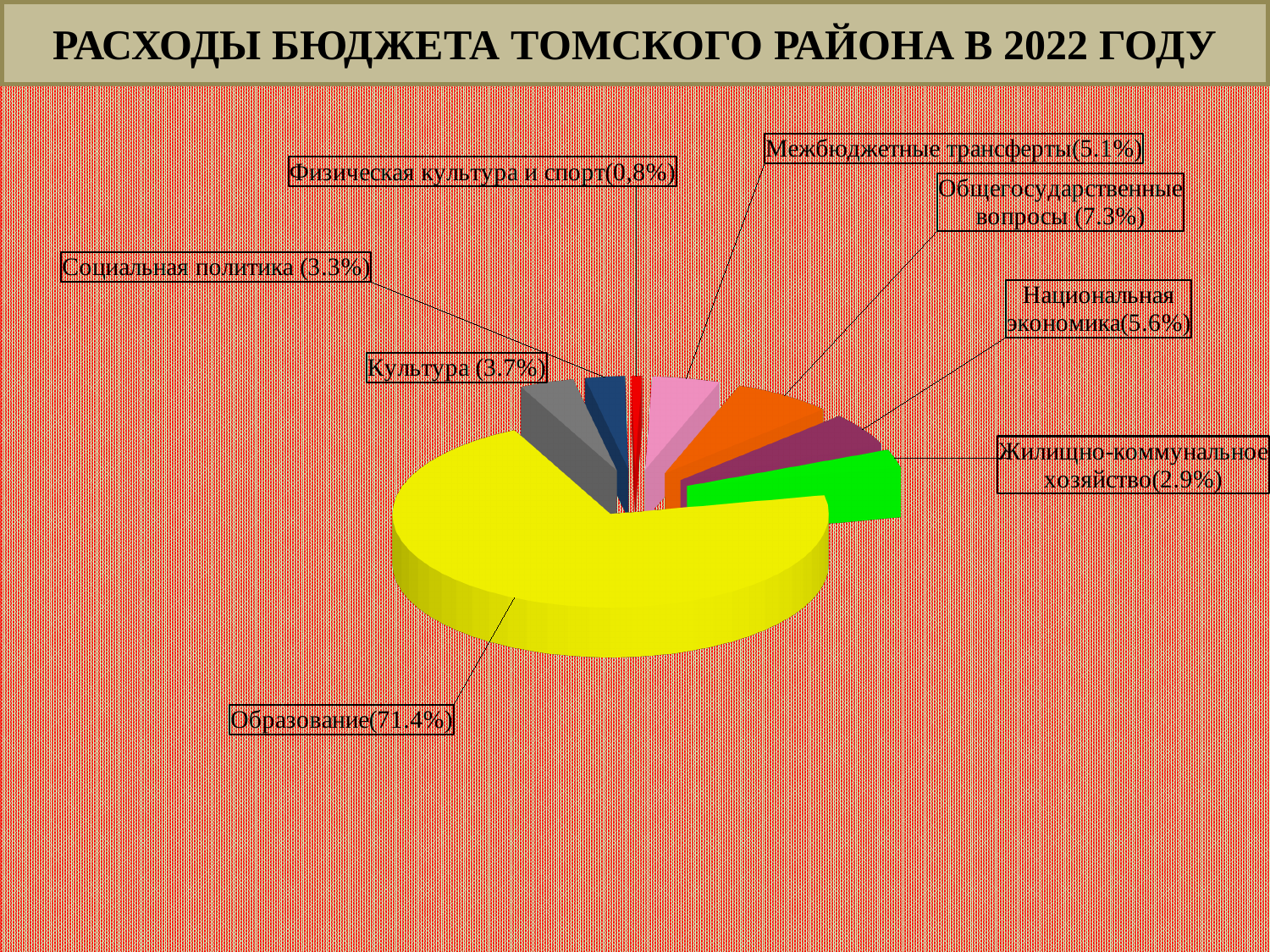
Which category has the smallest share of the pie? Физическая культура и спорт What is the value shown for Жилищно-коммунальное хозяйство? 2.9% What is the value shown for Национальная экономика? 5.6% What is the value shown for Физическая культура и спорт? 0,8% What is the value shown for Общегосударственные вопросы? 7.3% What is the title of the slide? РАСХОДЫ БЮДЖЕТА ТОМСКОГО РАЙОНА В 2022 ГОДУ What is the difference between the shares for Общегосударственные вопросы and Культура? 3.6% Which is larger, the share for Межбюджетные трансферты or the share for Социальная политика? Межбюджетные трансферты Which category has the largest share of the pie? Образование How many categories are shown in the pie chart? 8 What kind of chart is shown on the slide? pie chart What share of the budget expenditure goes to Образование? 71.4%